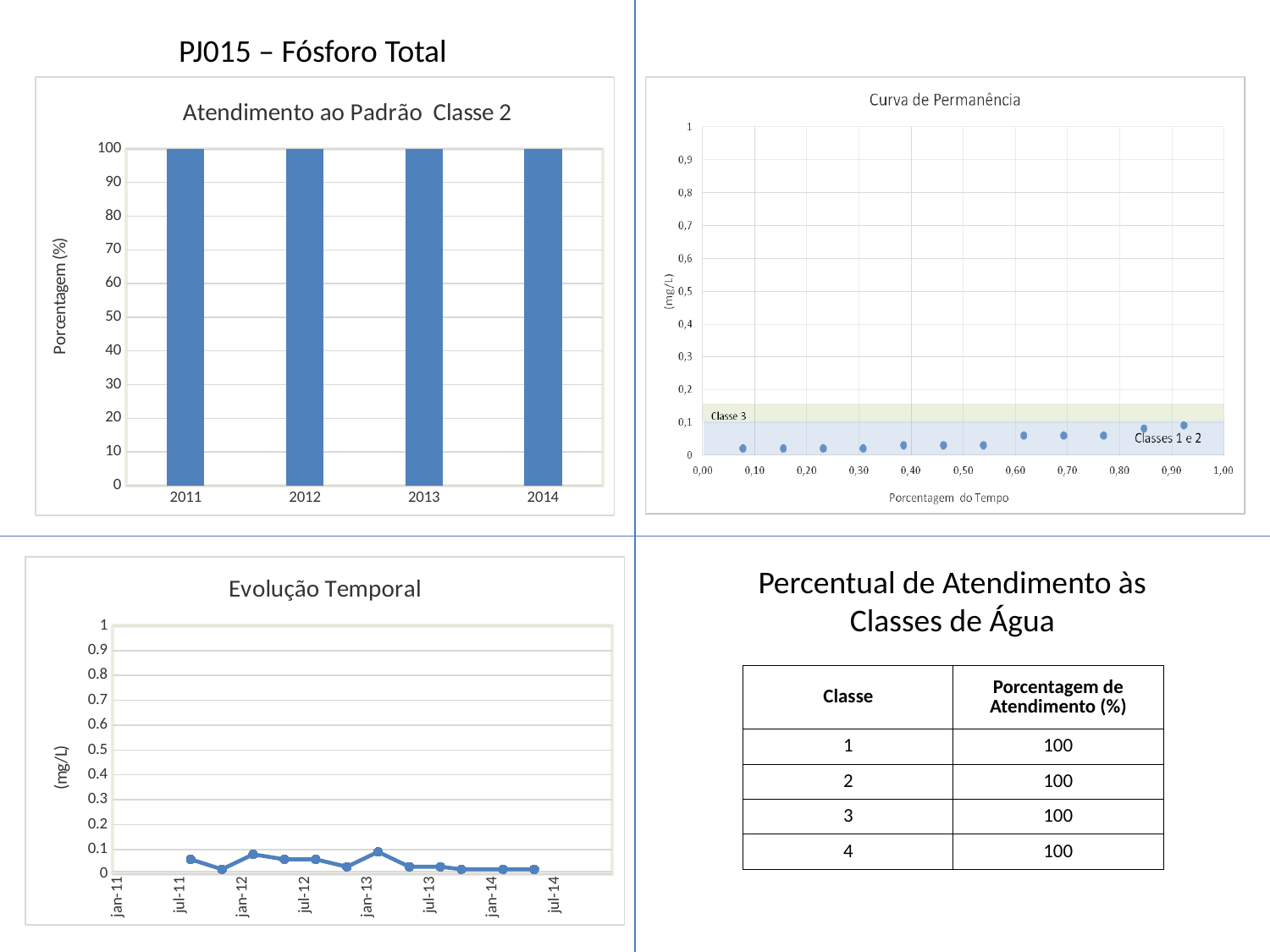
In the 'Curva de Permanência' chart, is the value at 0,50 on the x axis greater or less than 0,2? less In the 'Evolução Temporal' chart, is the value at jan-13 greater or less than 0.2? less In the 'Atendimento ao Padrão Classe 2' chart, what is the difference between the values for 2012 and 2013? 0 What kind of chart is 'Atendimento ao Padrão Classe 2'? bar chart In the 'Atendimento ao Padrão Classe 2' chart, what is the value for 2014? 100 In the 'Atendimento ao Padrão Classe 2' chart, what is the value for 2011? 100 In the 'Evolução Temporal' chart, do the values generally rise or fall from jul-11 to jul-14? fall What kind of chart is 'Evolução Temporal'? line chart In the 'Atendimento ao Padrão Classe 2' chart, how many years are shown on the x axis? 4 In the 'Curva de Permanência' chart, what is the x-axis title? Porcentagem do Tempo In the 'Atendimento ao Padrão Classe 2' chart, what is the y-axis label? Porcentagem (%) In the 'Curva de Permanência' chart, is the value at 0,10 on the x axis greater or less than 0,1? less